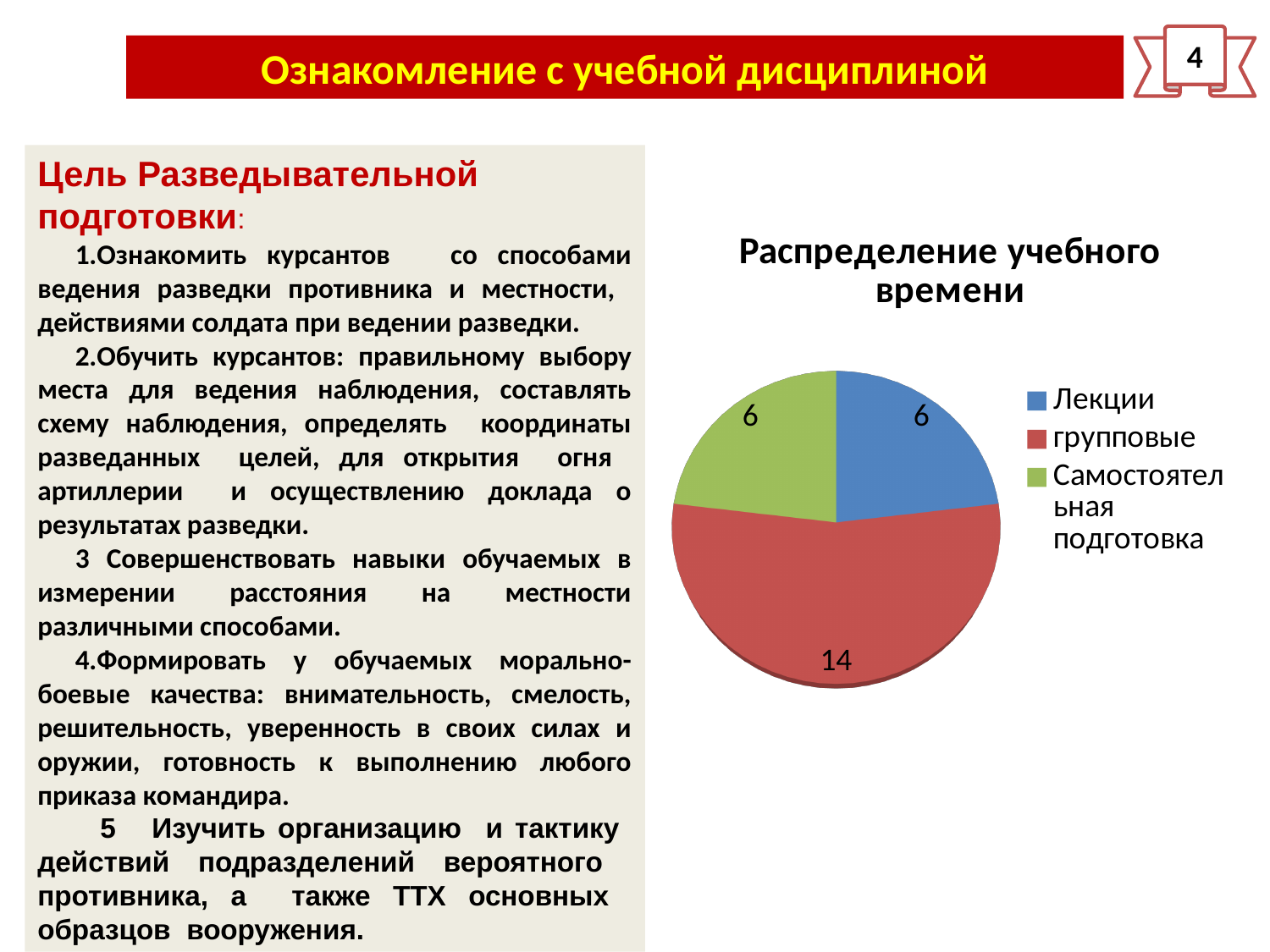
What is the value for групповые in the pie chart? 14 What is the title of the chart? Распределение учебного времени What colour is the slice for групповые? red What is the total of all the values shown in the pie chart? 26 Which is larger, the value for групповые or the value for Лекции? групповые What kind of chart is shown on the slide? pie chart What is the value for Лекции in the pie chart? 6 How many entries does the legend list? 3 What is the value for Самостоятельная подготовка in the pie chart? 6 How many slices does the pie chart have? 3 What is the difference between the value for групповые and the value for Лекции? 8 Which category has the largest slice of the pie? групповые